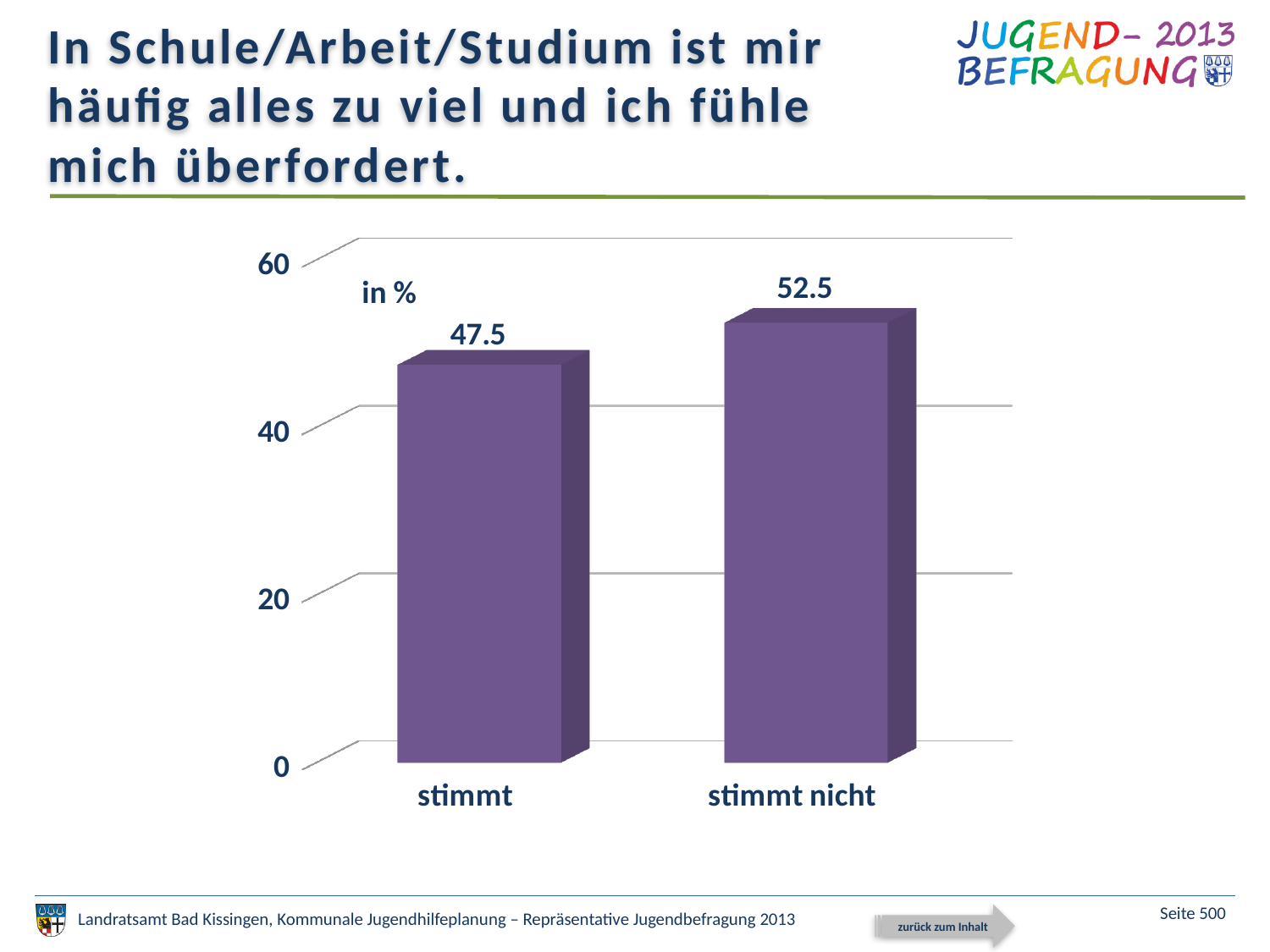
Is the value for "stimmt" greater or less than 40? greater Which category has the lowest value? stimmt What is the highest tick value shown on the vertical axis? 60 What is the value for "stimmt nicht"? 52.5 How many categories are shown on the x axis? 2 What is the difference between the values for "stimmt nicht" and "stimmt"? 5 What is the value for "stimmt"? 47.5 Which category has the highest value? stimmt nicht Is the value for "stimmt nicht" greater or less than 60? less Which is larger, the value for "stimmt" or the value for "stimmt nicht"? stimmt nicht What kind of chart is shown on the slide? bar chart What unit is indicated for the values in the chart? in %